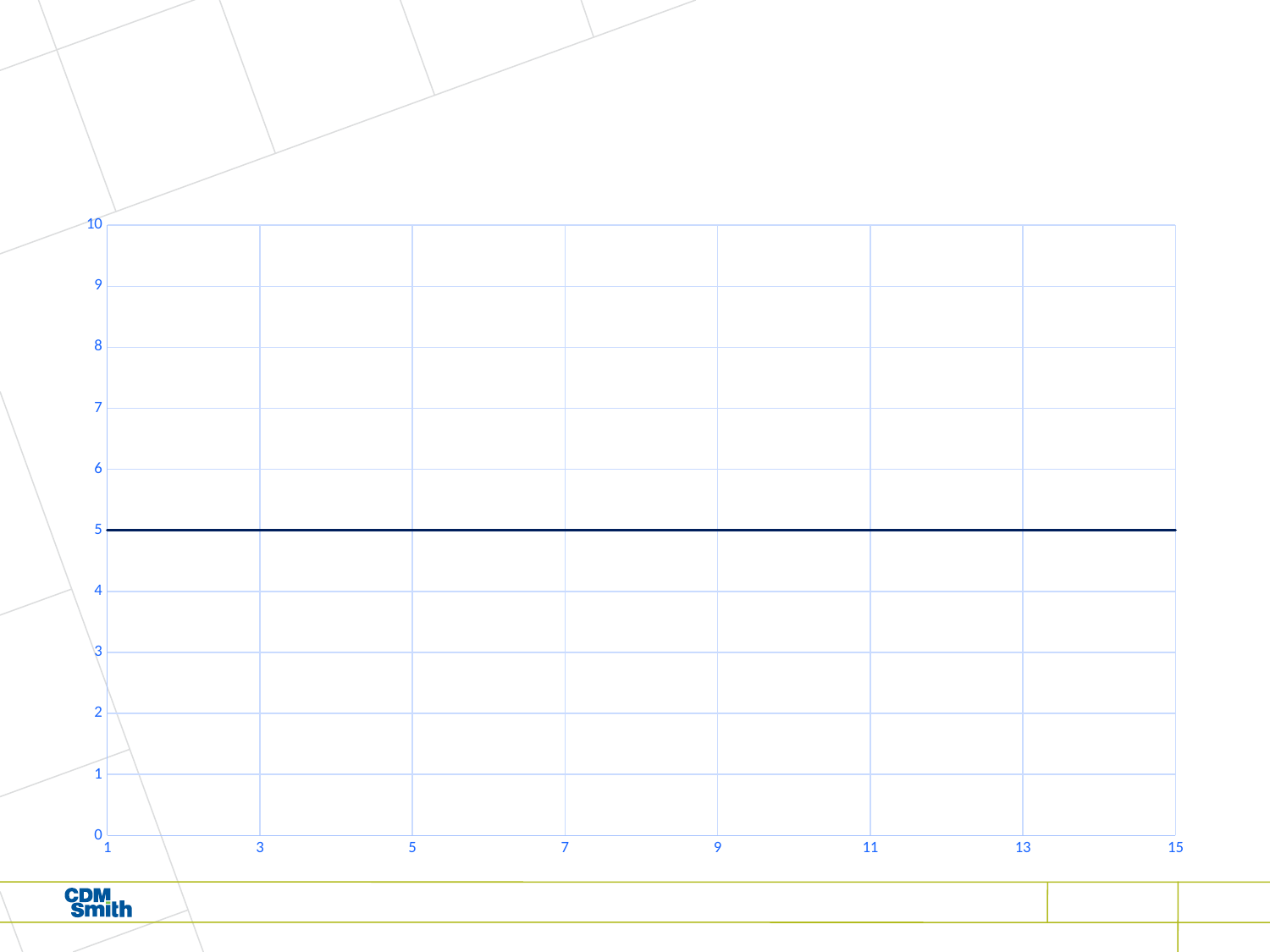
What kind of chart is shown on the slide? line chart What is the plotted value at x = 15? 5 Is the plotted value at x = 11 greater or less than 6? less What is the difference between the plotted value at x = 1 and the plotted value at x = 15? 0 How many tick labels are shown on the x axis? 8 What is the plotted value at x = 9? 5 What is the plotted value at x = 1? 5 Is the plotted value at x = 7 greater or less than 4? greater What is the highest value labelled on the y axis? 10 What is the lowest value labelled on the x axis? 1 Do the plotted values rise, fall, or stay flat as x increases from 1 to 15? stay flat